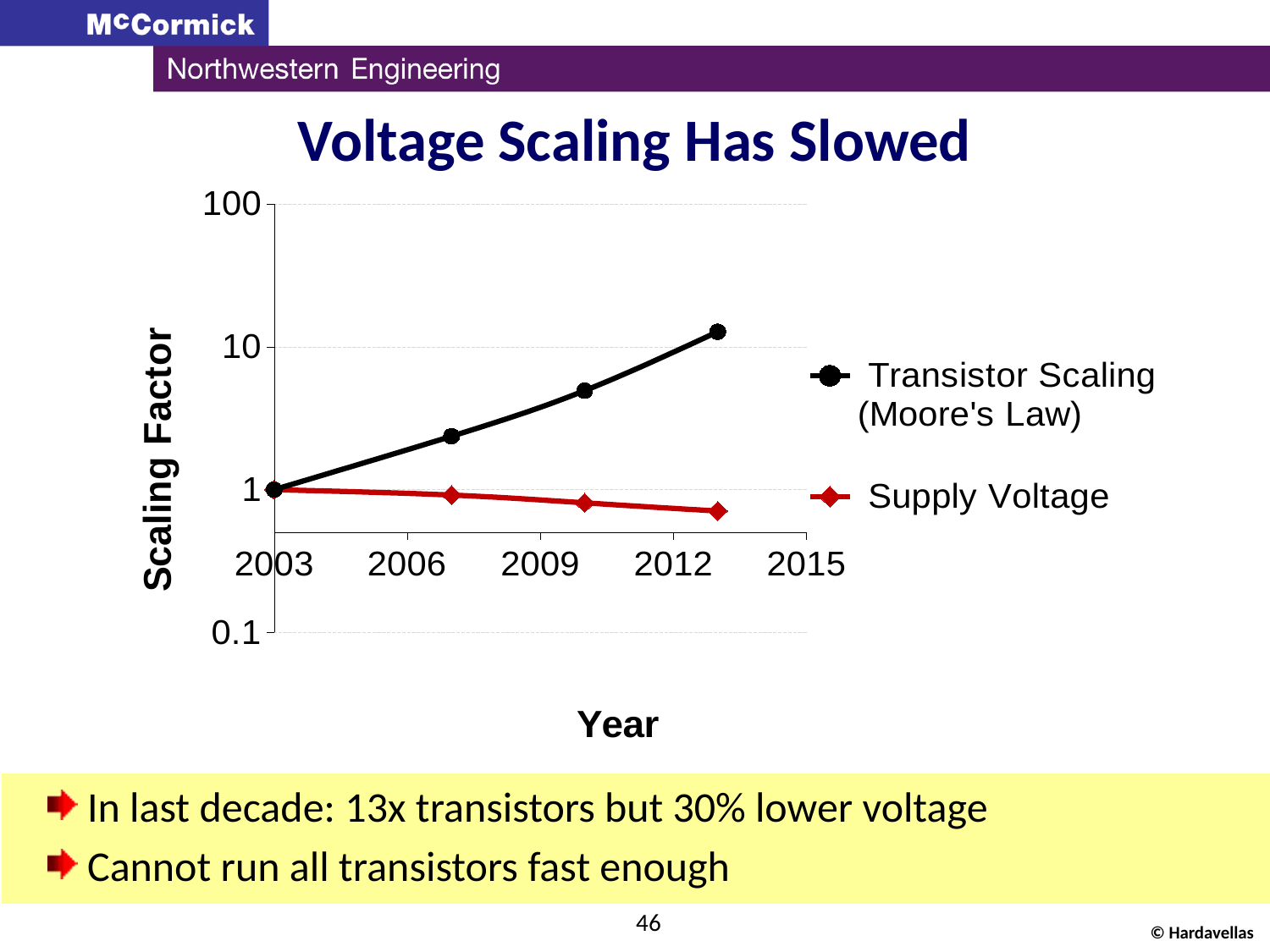
How many series does the legend list? 2 How many data points are plotted for the Supply Voltage series? 4 What kind of chart is shown on the slide? line chart What is the value of Transistor Scaling (Moore's Law) in 2003? 1 Is the last plotted value of Supply Voltage greater or less than 1? less Is the last plotted value of Transistor Scaling (Moore's Law) greater or less than 10? greater What is the title of the chart? Voltage Scaling Has Slowed Does the Transistor Scaling (Moore's Law) series rise or fall over the years? rise What is the value of Supply Voltage in 2003? 1 What is the label of the y axis? Scaling Factor Does the Supply Voltage series rise or fall over the years? fall At the last plotted year, which series has the larger value, Transistor Scaling (Moore's Law) or Supply Voltage? Transistor Scaling (Moore's Law)